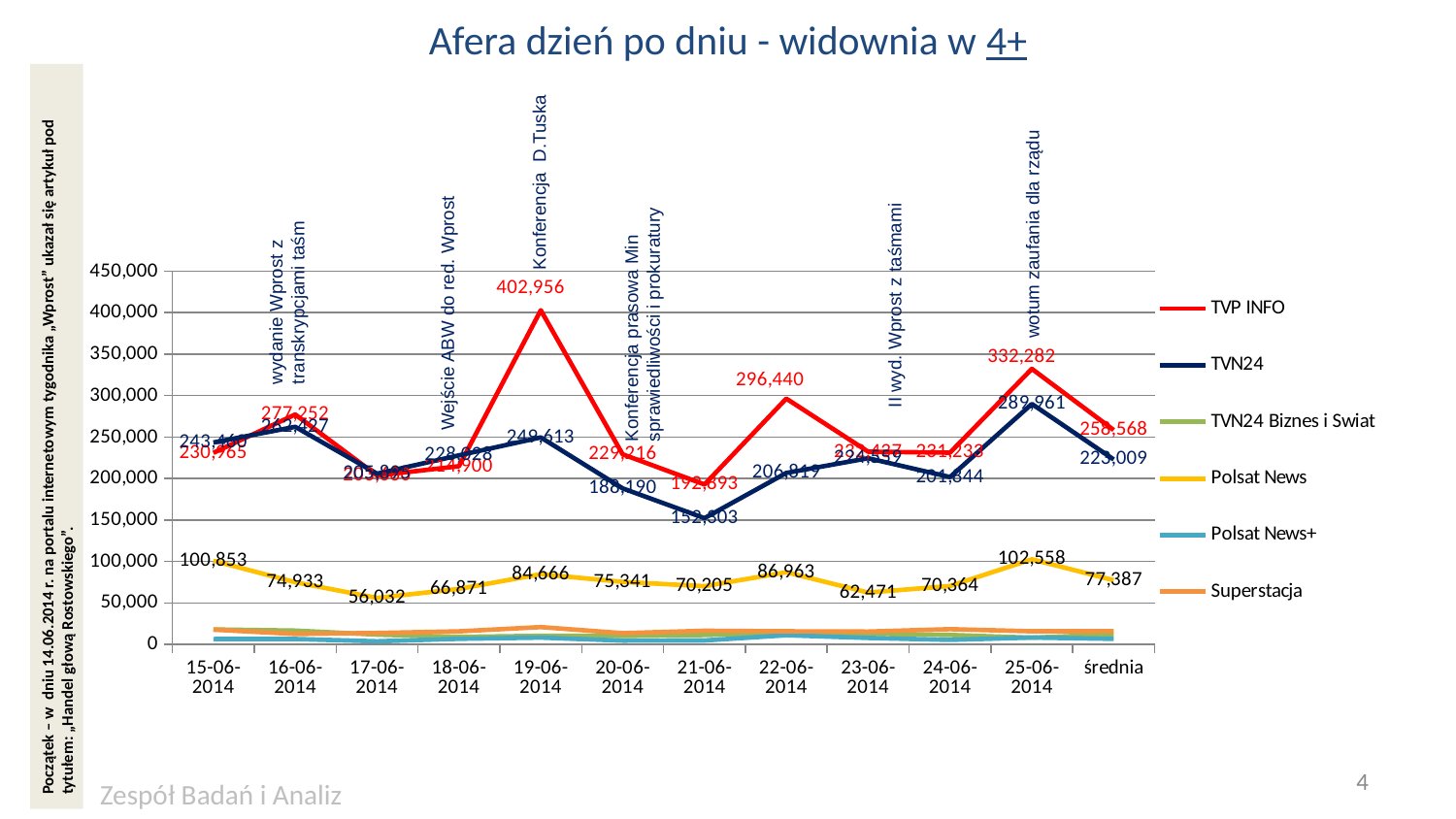
What colour is the TVP INFO line? red How many points are there along the x axis (including średnia)? 12 What type of chart is shown on the slide? line chart Is the value for TVN24 on 21-06-2014 greater or less than 200,000? less What is the difference between the Polsat News values on 25-06-2014 and 15-06-2014? 1,705 What is the value for TVN24 on 21-06-2014? 152,303 On which date does Polsat News reach its highest value? 25-06-2014 How many series does the legend list? 6 What is the średnia (average) value for Polsat News? 77,387 On which date does TVN24 have its lowest value? 21-06-2014 Which is larger on 25-06-2014, TVP INFO or TVN24? TVP INFO What is the value for TVP INFO on 19-06-2014? 402,956